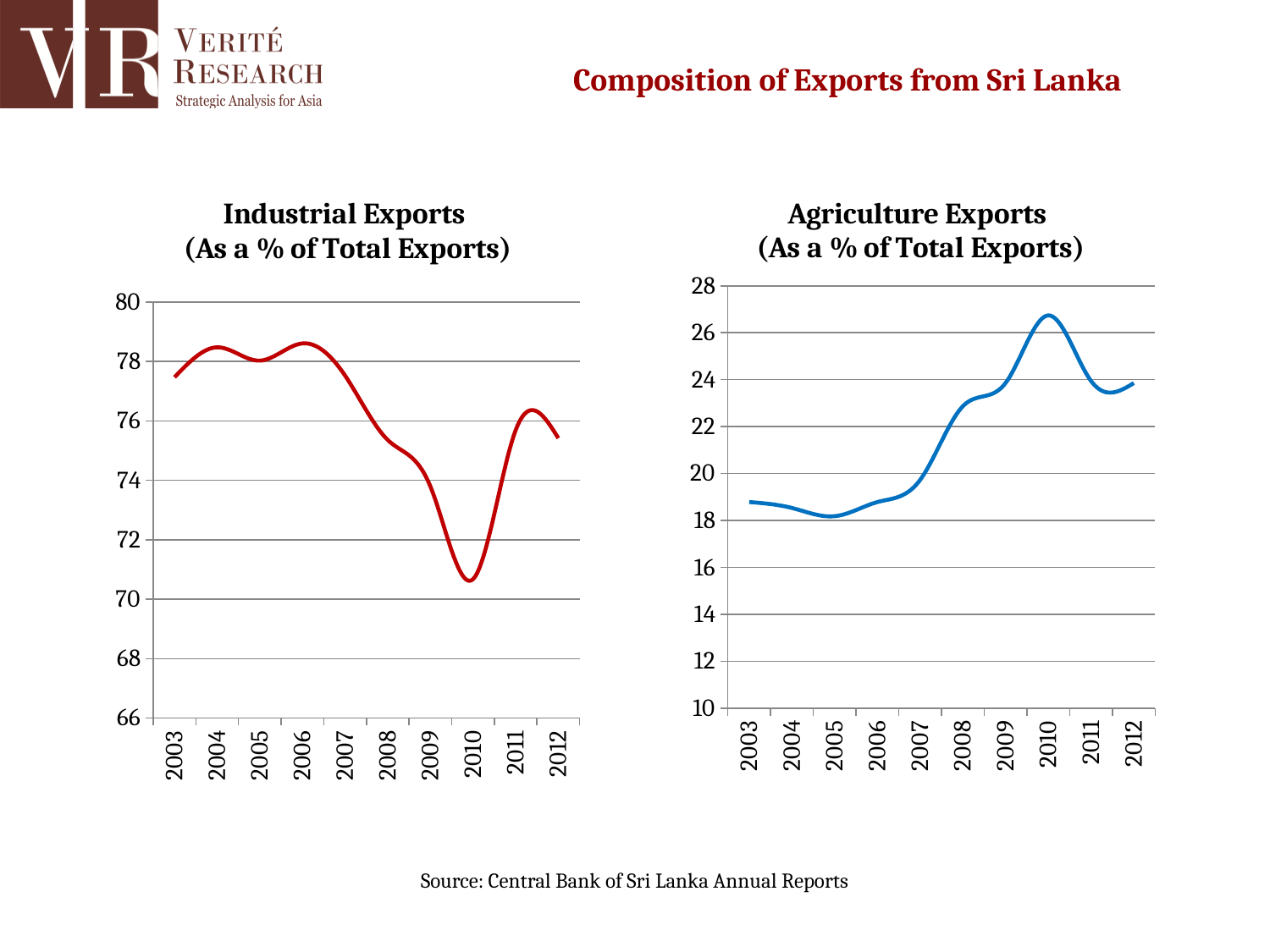
In the Agriculture Exports chart, how many years are shown on the x axis? 10 In the Agriculture Exports chart, do the values generally rise or fall from 2005 to 2010? rise In the Industrial Exports chart, which year has the lowest value? 2010 What kind of chart is the Industrial Exports chart? line chart What kind of chart is the Agriculture Exports chart? line chart In the Agriculture Exports chart, is the value for 2003 greater or less than 20? less In the Agriculture Exports chart, which year has the highest value? 2010 In the Agriculture Exports chart, is the value for 2010 larger or smaller than the value for 2005? larger In the Industrial Exports chart, is the value for 2003 greater or less than 76? greater In the Industrial Exports chart, how many years are shown on the x axis? 10 In the Industrial Exports chart, is the value for 2010 greater or less than 72? less